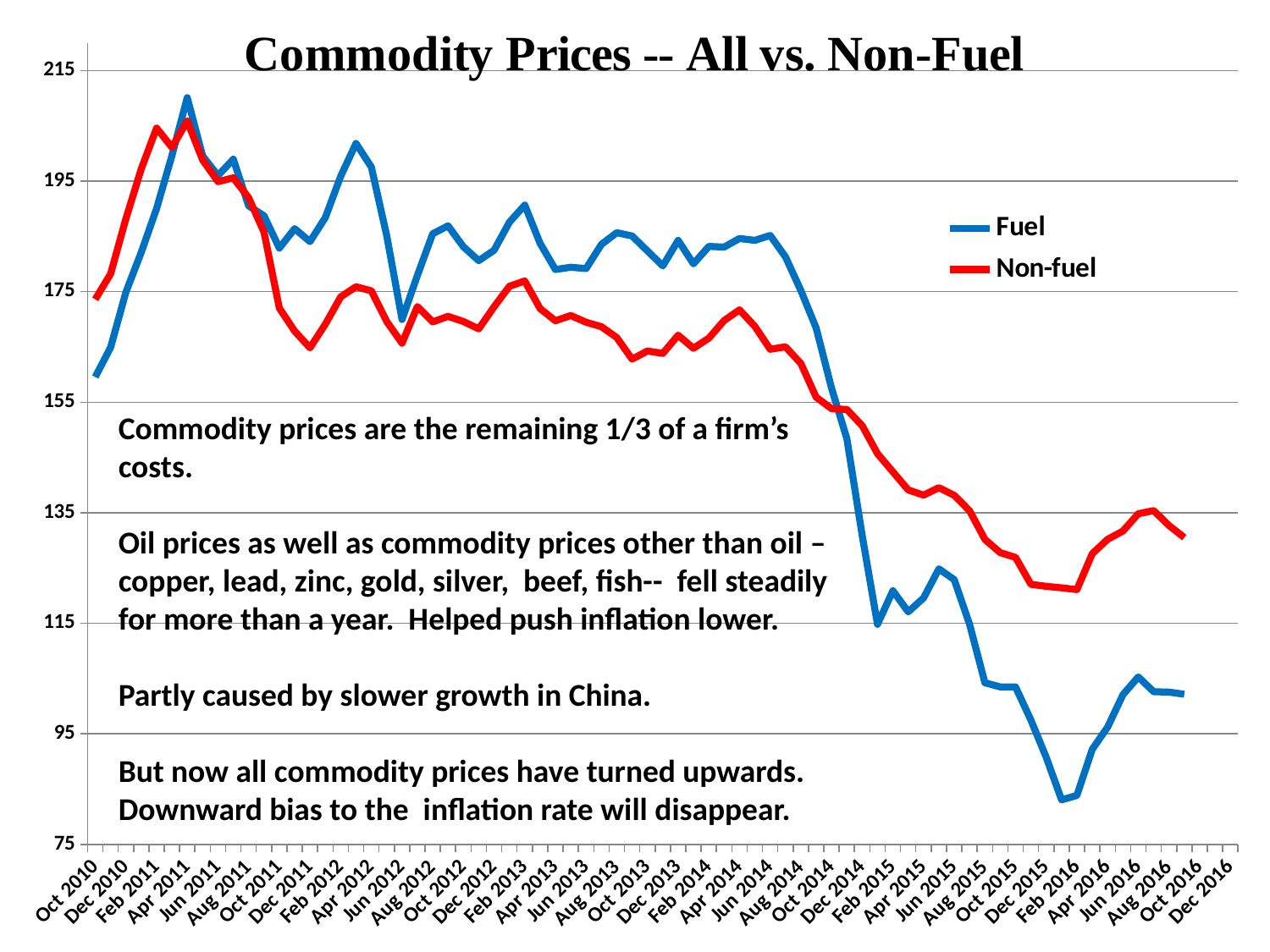
Which colour is used for the Non-fuel series? Red What is the title of the chart? Commodity Prices -- All vs. Non-Fuel How many series does the legend list? 2 Is the Fuel value for Apr 2011 greater or less than 195? greater Is the Fuel value for Oct 2010 greater or less than 175? less Does the Fuel series rise or fall between Jun 2014 and Feb 2015? Fall In Apr 2012, which series has the higher value, Fuel or Non-fuel? Fuel Which series reaches the lowest point on the chart? Fuel Is the Fuel value for Feb 2016 greater or less than 95? less What kind of chart is shown on the slide? Line chart In Feb 2016, which series has the higher value, Fuel or Non-fuel? Non-fuel